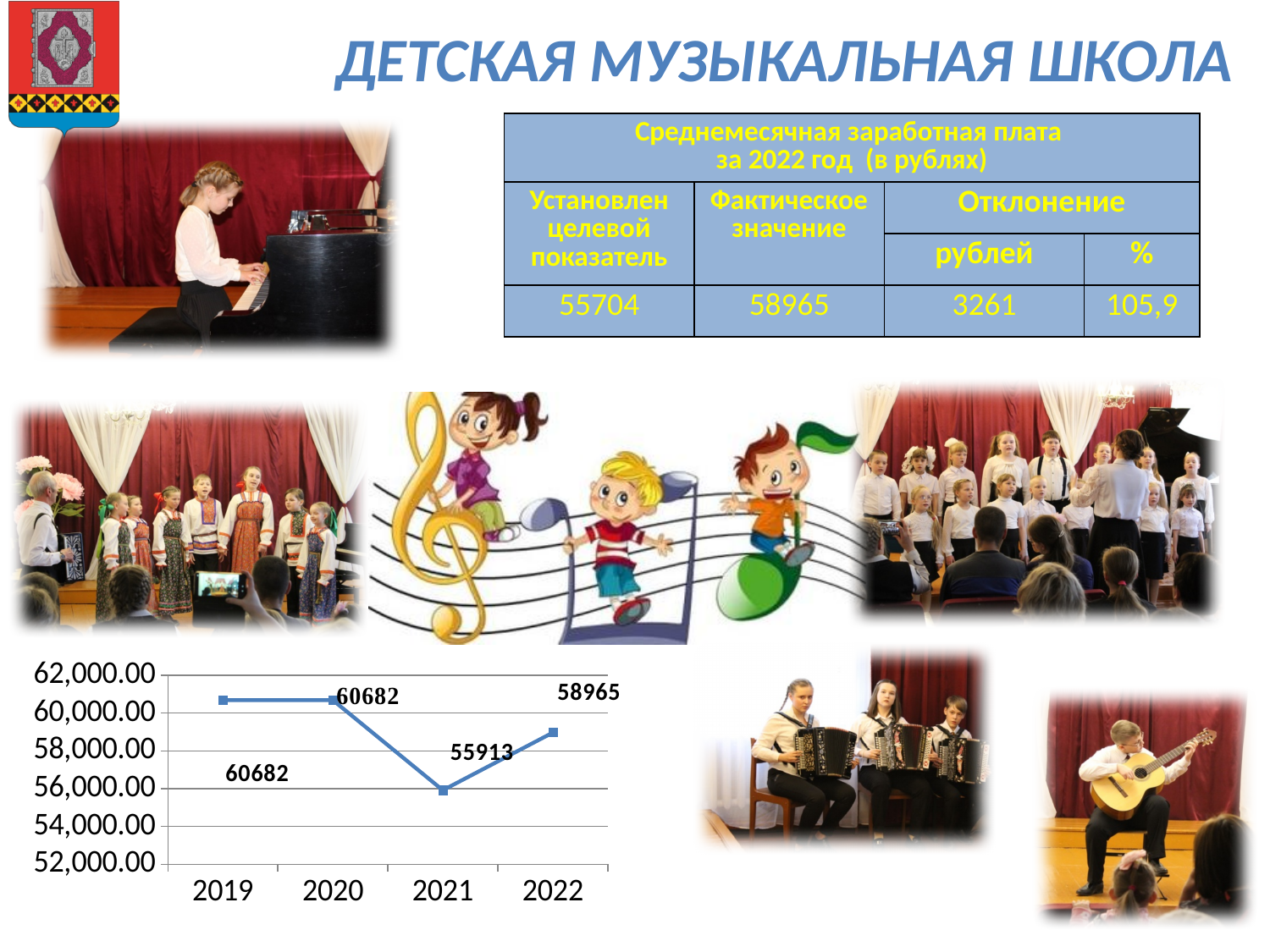
In the line chart, which year has the lowest value? 2021 In the line chart, what is the value for 2020? 60682 In the line chart, what is the difference between the values for 2020 and 2021? 4769 In the line chart, is the value for 2021 greater or less than 56,000.00? less What kind of chart is shown at the bottom left of the slide? line chart In the line chart, does the value rise or fall from 2021 to 2022? rise In the line chart, what is the difference between the values for 2022 and 2021? 3052 In the line chart, what is the value for 2021? 55913 In the line chart, what is the value for 2019? 60682 In the line chart, which is larger, the value for 2019 or the value for 2022? 2019 In the line chart, what is the value for 2022? 58965 How many years are plotted on the x axis of the line chart? 4